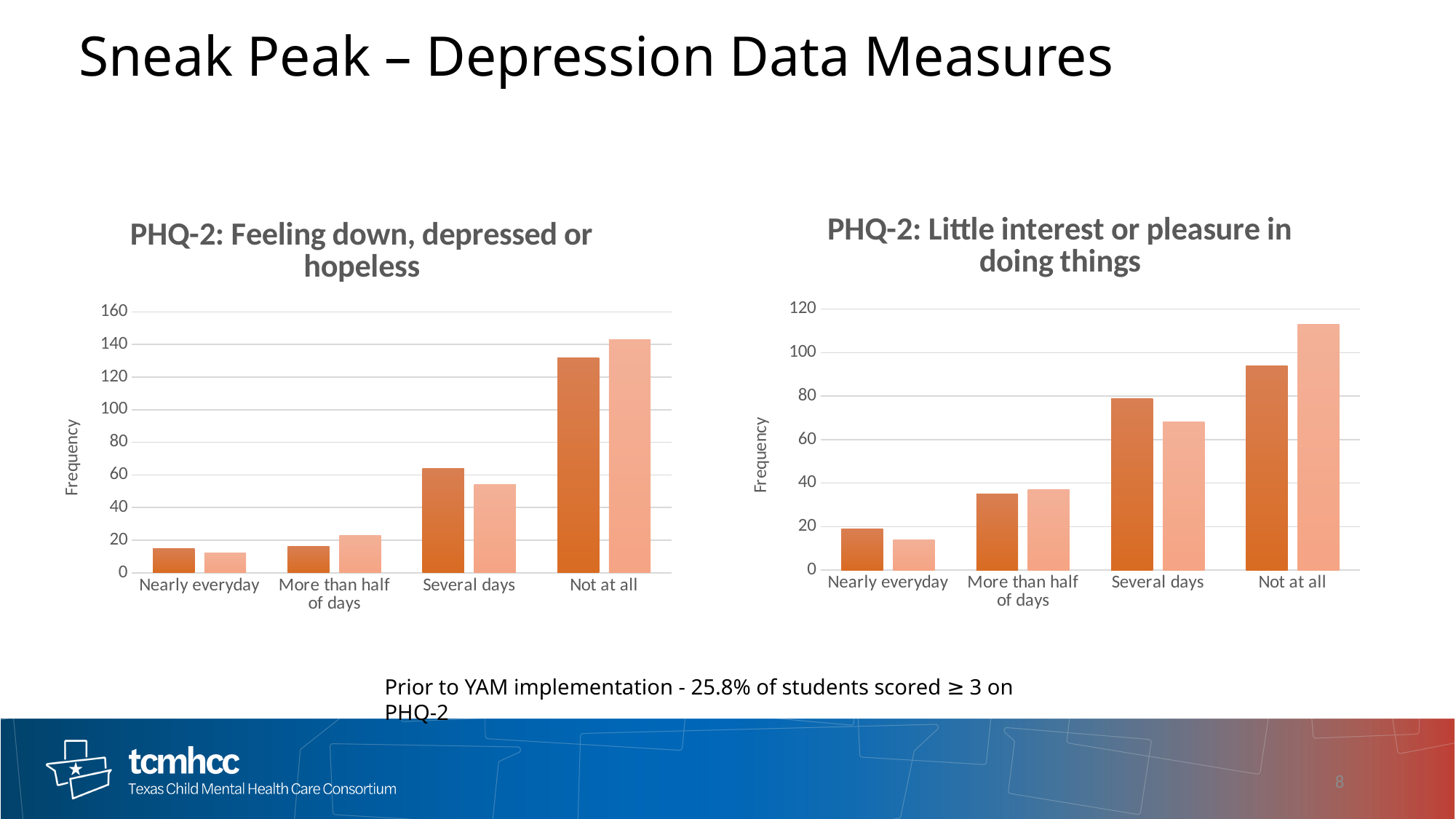
What kind of chart is the left chart titled 'PHQ-2: Feeling down, depressed or hopeless'? bar chart How many categories are shown on the x axis of the right chart titled 'PHQ-2: Little interest or pleasure in doing things'? 4 In the right chart 'PHQ-2: Little interest or pleasure in doing things', which is larger for 'Several days': the dark orange bar or the light orange bar? the dark orange bar In the left chart 'PHQ-2: Feeling down, depressed or hopeless', which category has the highest bars? Not at all In the right chart 'PHQ-2: Little interest or pleasure in doing things', which category has the lowest bars? Nearly everyday In the right chart 'PHQ-2: Little interest or pleasure in doing things', is the value of the dark orange bar for 'Several days' greater or less than 60? greater What is the highest value shown on the y axis of the right chart 'PHQ-2: Little interest or pleasure in doing things'? 120 In the left chart 'PHQ-2: Feeling down, depressed or hopeless', is the value of the dark orange bar for 'Several days' greater or less than 80? less In the left chart 'PHQ-2: Feeling down, depressed or hopeless', is the value of the dark orange bar for 'Not at all' greater or less than 120? greater In the left chart 'PHQ-2: Feeling down, depressed or hopeless', do the bar values generally rise or fall moving from 'Nearly everyday' to 'Not at all' along the x axis? rise What is the label on the y axis of the left chart 'PHQ-2: Feeling down, depressed or hopeless'? Frequency